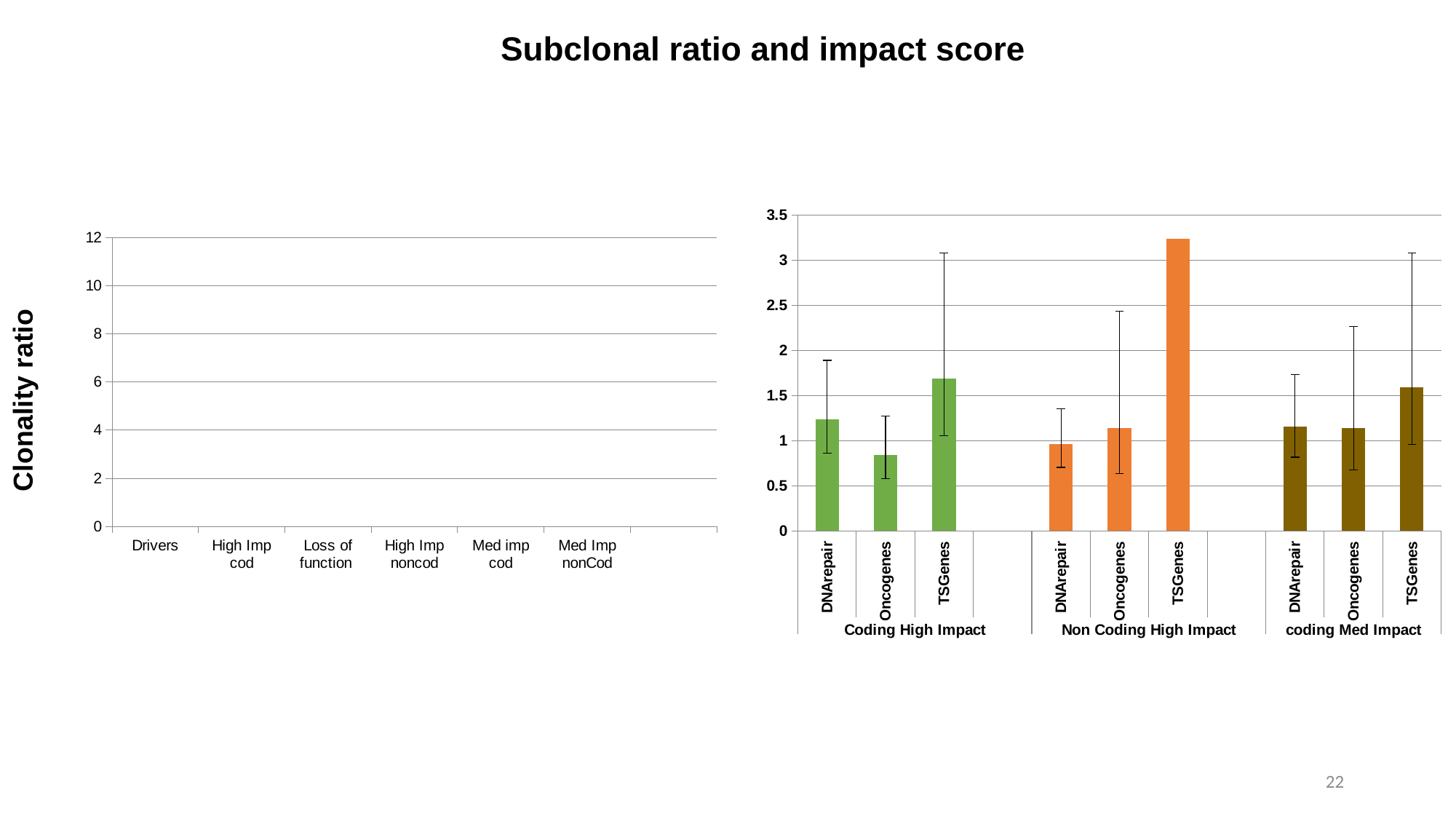
In the chart on the right, is the value for TSGenes under Non Coding High Impact greater or less than 3? greater In the chart on the right, which is larger: DNArepair under Coding High Impact or Oncogenes under Coding High Impact? DNArepair What is the y-axis label of the chart on the left? Clonality ratio In the chart on the right, is the value for TSGenes under Coding High Impact greater or less than 1.5? greater In the chart on the right, which bar is the highest overall? TSGenes in Non Coding High Impact How many categories are listed on the x axis of the chart on the left? 6 In the chart on the right, which bar is the lowest overall? Oncogenes in Coding High Impact What kind of chart is the chart on the right of the slide? bar chart In the chart on the right, is the value for Oncogenes under Coding High Impact greater or less than 1? less In the chart on the right, which is larger: TSGenes under Coding High Impact or TSGenes under Non Coding High Impact? TSGenes under Non Coding High Impact How many bars are plotted in the chart on the right? 9